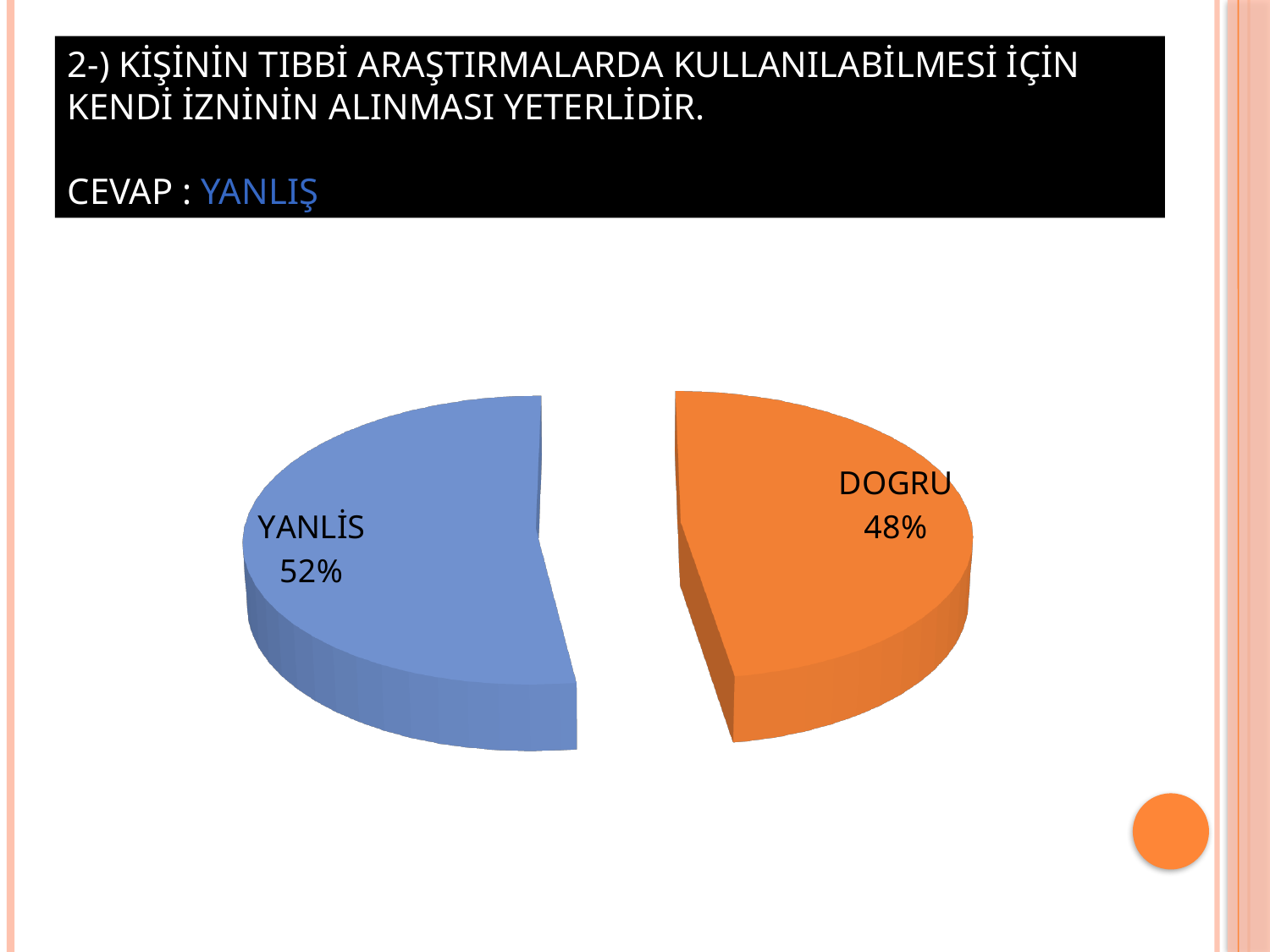
What share of the pie does the DOGRU slice represent? 48% How many slices does the pie chart have? 2 What colour is the YANLİS slice? blue What colour is the DOGRU slice? orange Which is larger, the YANLİS slice or the DOGRU slice? YANLİS What share of the pie does the YANLİS slice represent? 52% Which slice of the pie is the largest? YANLİS What is the difference in percentage points between the YANLİS and DOGRU slices? 4% Which slice of the pie is the smallest? DOGRU What kind of chart is shown on the slide? pie chart